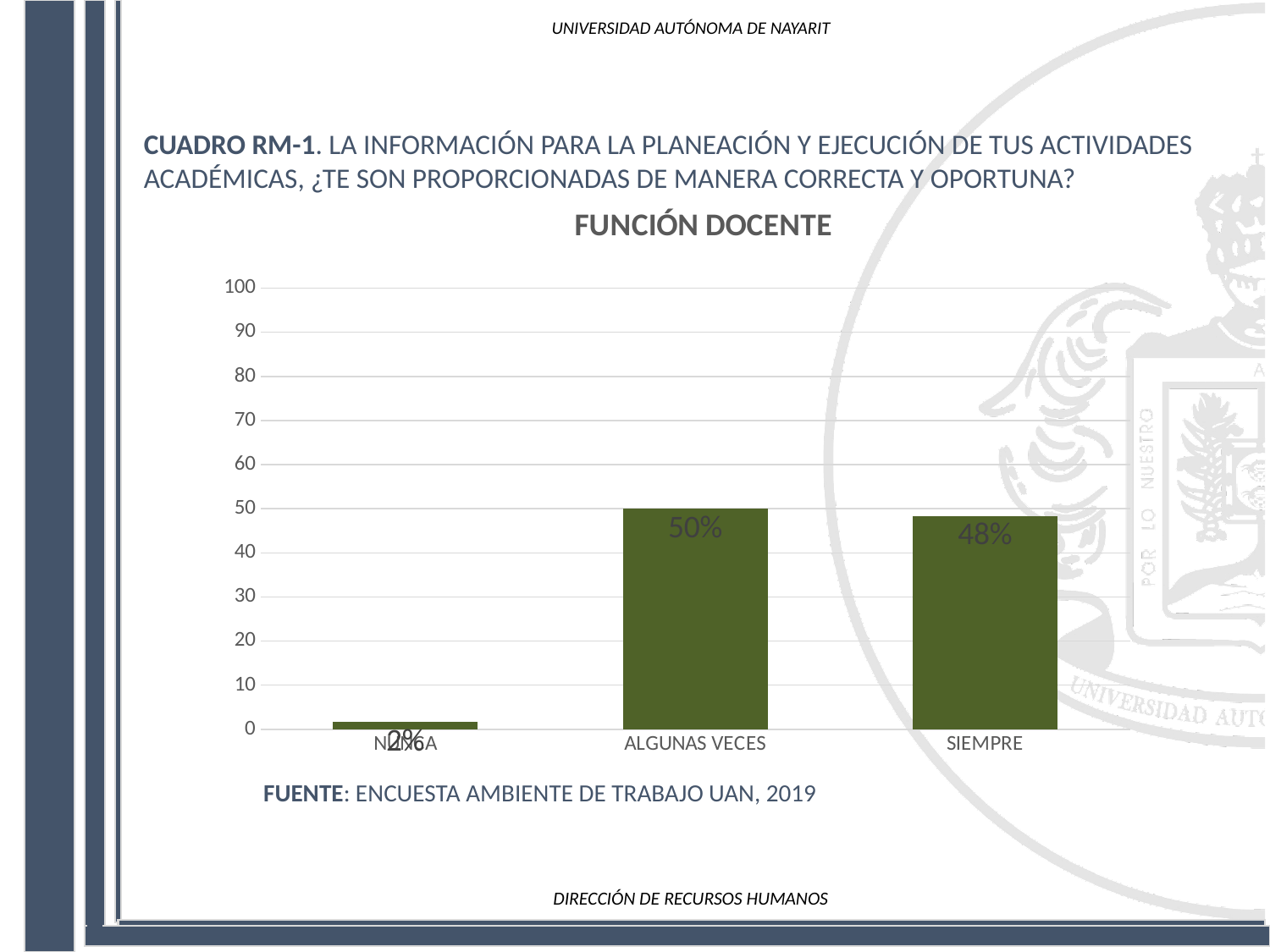
What is the difference between the values for ALGUNAS VECES and SIEMPRE? 2% What is the title of the chart? FUNCIÓN DOCENTE What is the value for ALGUNAS VECES? 50% What is the value for SIEMPRE? 48% Which category has the highest value? ALGUNAS VECES Which is larger, the value for SIEMPRE or the value for NUNCA? SIEMPRE Which category has the lowest value? NUNCA What is the difference between the values for SIEMPRE and NUNCA? 46% How many categories are shown on the x axis of the chart? 3 What kind of chart is shown on the slide? bar chart What is the value for NUNCA? 2% Is the value for SIEMPRE greater or less than 30? greater